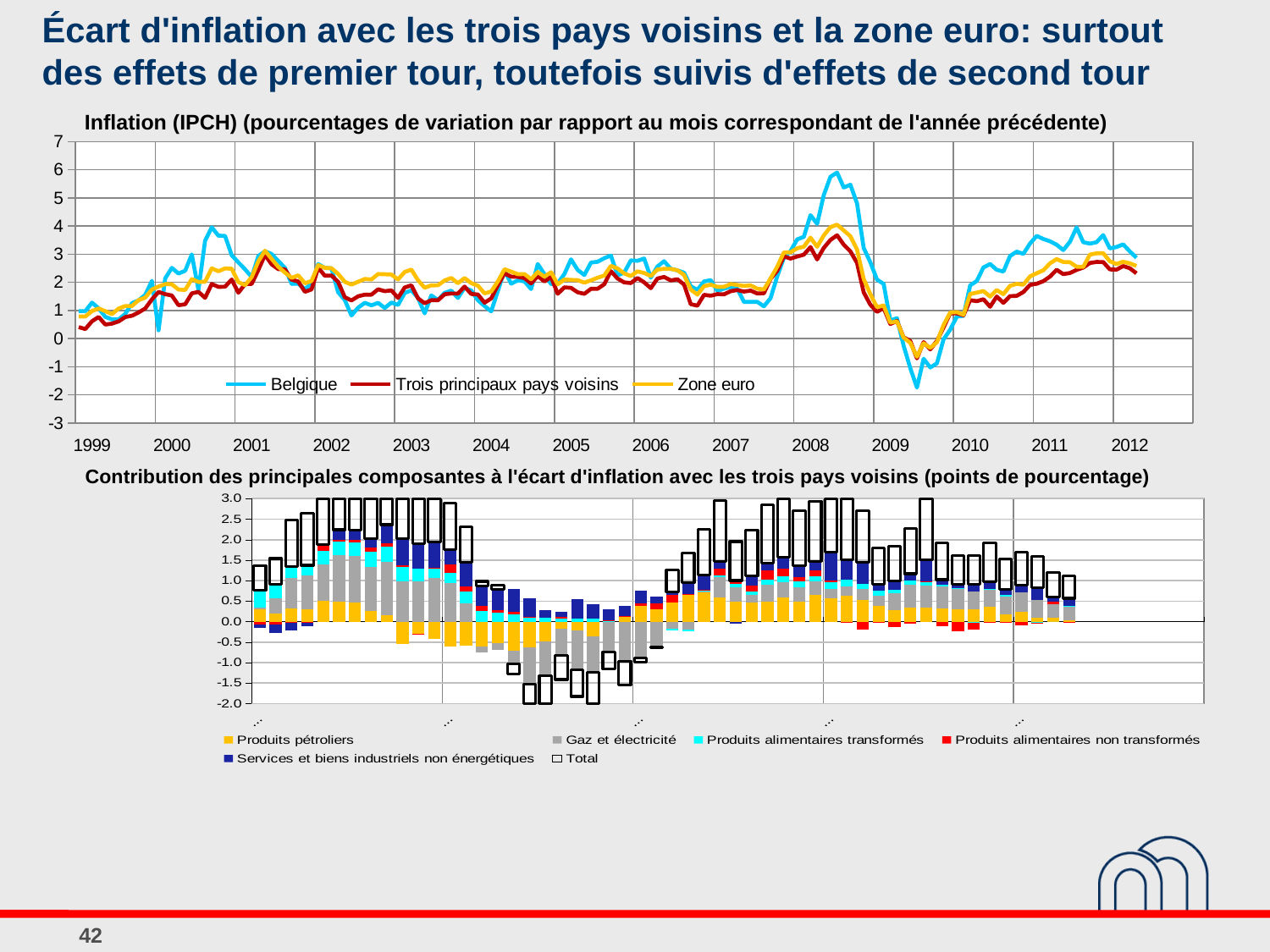
In the bottom chart 'Contribution des principales composantes', how many entries does the legend list? 6 In the top chart 'Inflation (IPCH)', how many year labels are shown on the x axis? 14 In the top chart 'Inflation (IPCH)', is the peak value for Belgique in 2008 greater or less than 5? greater In the top chart 'Inflation (IPCH)', which series falls to the lowest value in 2009? Belgique In the top chart 'Inflation (IPCH)', is the lowest value for Belgique in 2009 greater or less than -1? less In the top chart 'Inflation (IPCH)', how many series does the legend list? 3 In the top chart 'Inflation (IPCH)', do the values for Belgique rise or fall between the 2008 peak and 2009? fall What kind of chart is the bottom chart titled 'Contribution des principales composantes à l'écart d'inflation avec les trois pays voisins'? stacked bar chart What kind of chart is the top chart titled 'Inflation (IPCH)'? line chart In the top chart 'Inflation (IPCH)', which series is drawn in light blue? Belgique In the top chart 'Inflation (IPCH)', which series reaches the highest value at the 2008 peak? Belgique In the top chart 'Inflation (IPCH)', is the 2008 peak value for Trois principaux pays voisins greater or less than 4? less